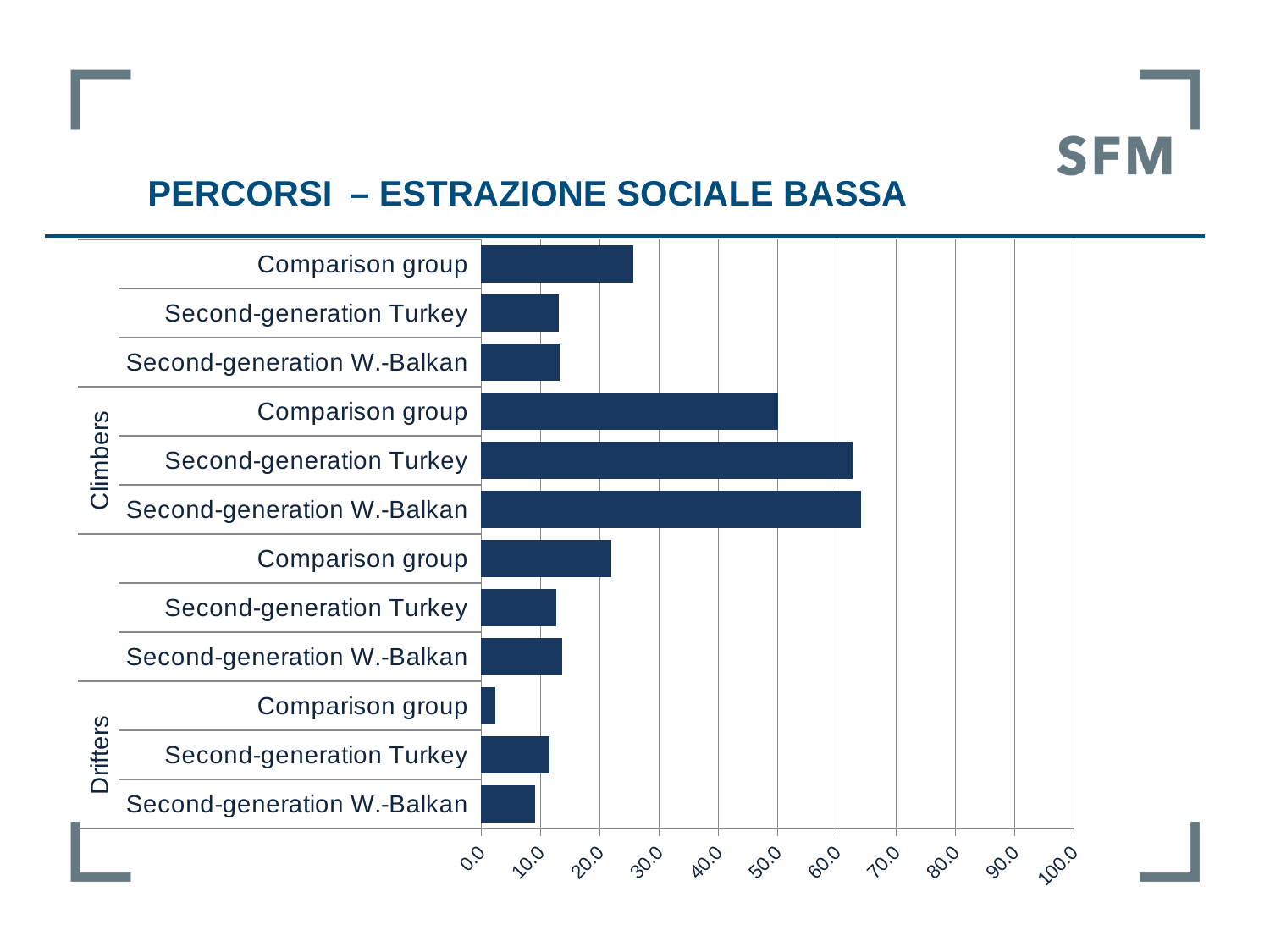
Is the value for Second-generation W.-Balkan in the Climbers group greater or less than 60.0? greater How many bars are plotted in the Climbers group? 3 Within the Climbers group, which is larger: Comparison group or Second-generation Turkey? Second-generation Turkey What is the title of the slide containing the chart? PERCORSI – ESTRAZIONE SOCIALE BASSA Which bar in the chart is the shortest? Comparison group (Drifters) How many bars are plotted in the chart? 12 Within the Drifters group, which is larger: Second-generation Turkey or Second-generation W.-Balkan? Second-generation Turkey Within the Drifters group, which is larger: Comparison group or Second-generation Turkey? Second-generation Turkey Is the value for Comparison group in the Climbers group greater or less than 40.0? greater Is the value for Comparison group in the Drifters group greater or less than 10.0? less What kind of chart is shown on the slide? bar chart What is the highest value shown on the chart's horizontal axis? 100.0